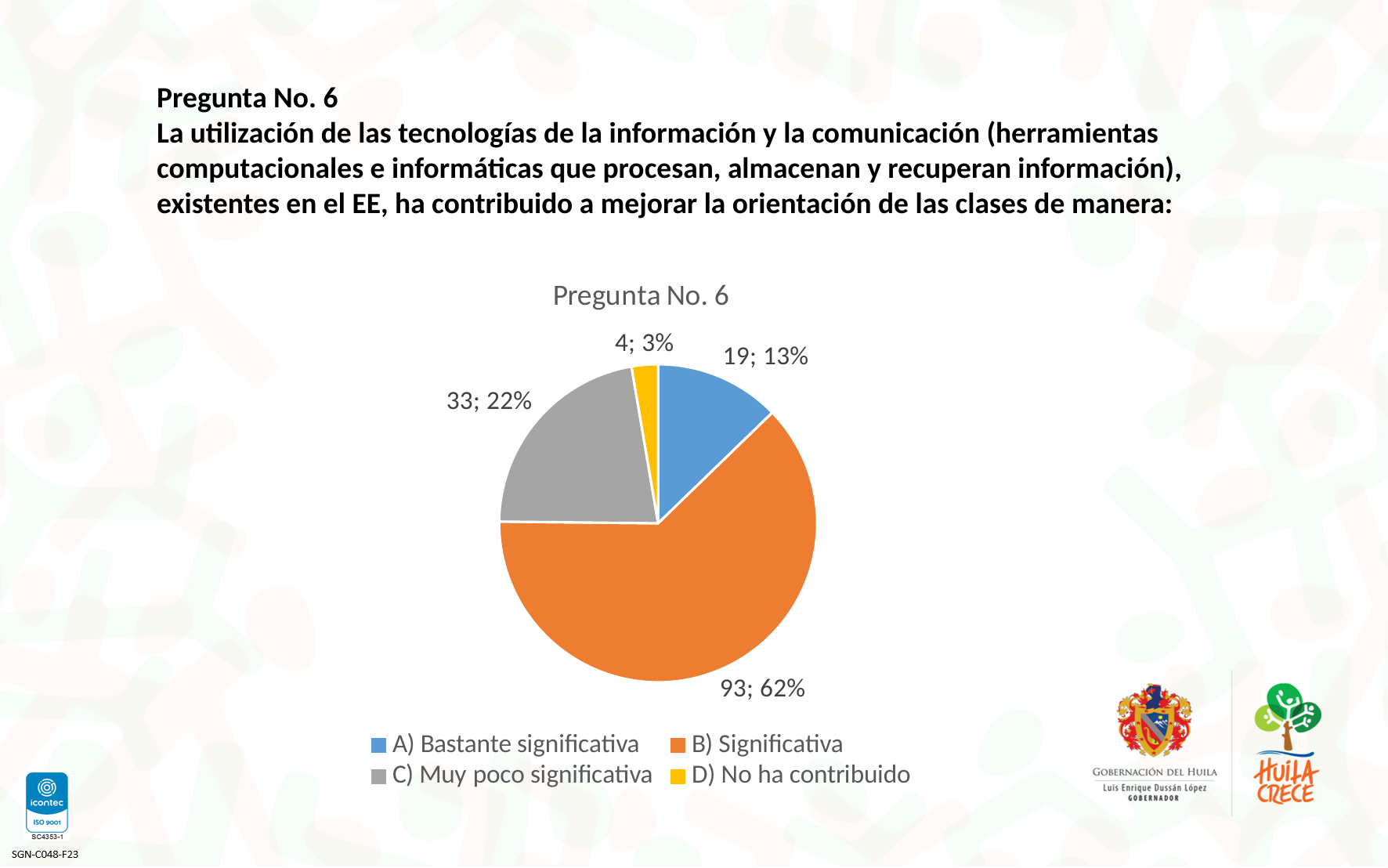
Which is larger, the count for 'A) Bastante significativa' or 'C) Muy poco significativa'? C) Muy poco significativa What percentage share does 'D) No ha contribuido' have? 3% What is the difference in count between 'B) Significativa' and 'C) Muy poco significativa'? 60 Which category has the largest slice? B) Significativa What kind of chart is shown on the slide? Pie chart What is the count for 'B) Significativa'? 93 What percentage share does 'C) Muy poco significativa' have? 22% What is the title of the chart? Pregunta No. 6 What is the count for 'A) Bastante significativa'? 19 How many entries does the legend list? 4 How many slices does the pie chart have? 4 Which category has the smallest slice? D) No ha contribuido